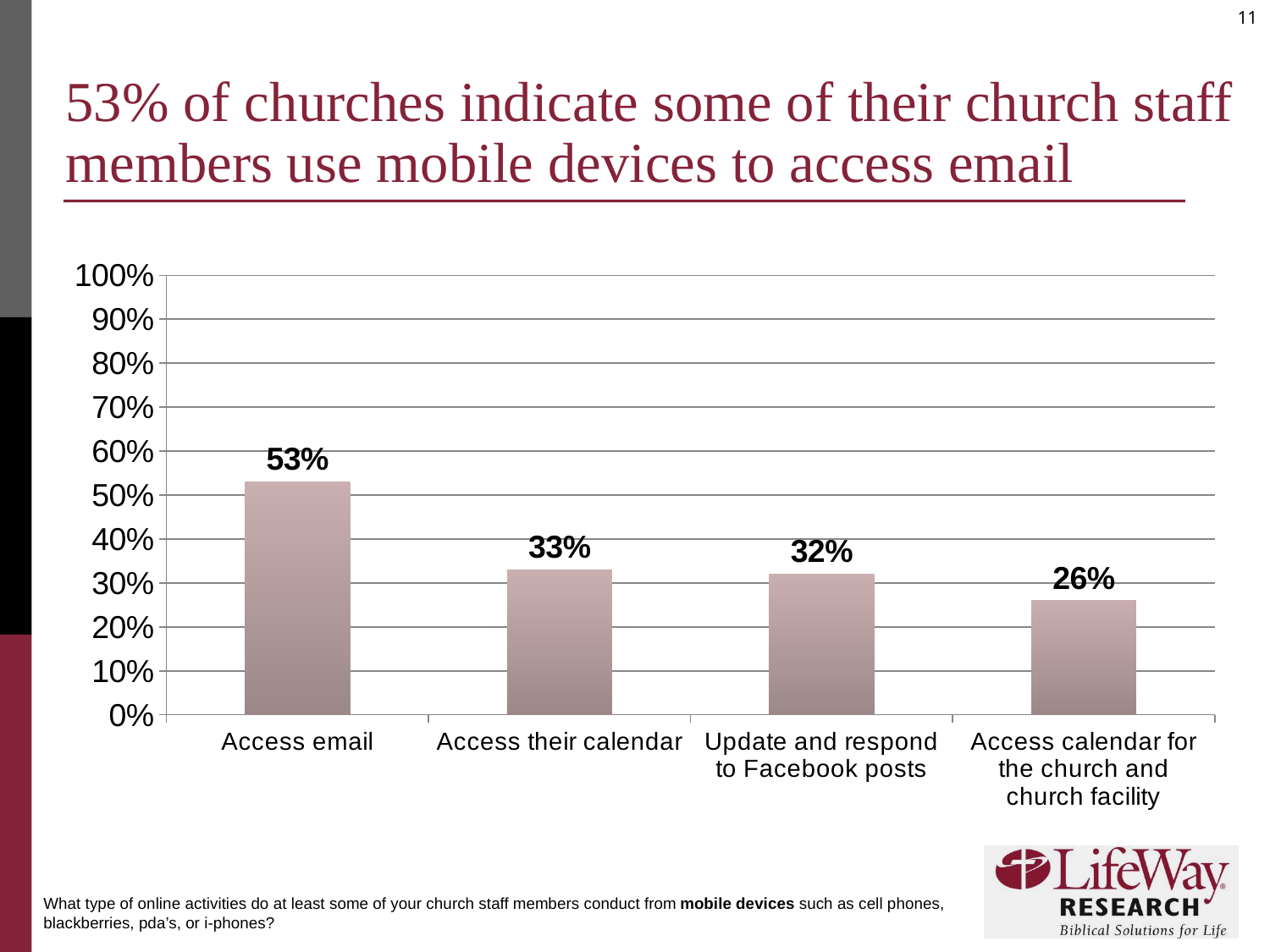
What is the difference between the values for 'Access email' and 'Access their calendar'? 20 percentage points Which activity has the lowest percentage? Access calendar for the church and church facility How many activity categories are shown in the chart? 4 What percentage of churches indicate staff members use mobile devices to access email? 53% What is the value for 'Access calendar for the church and church facility'? 26% Which is larger, the value for 'Access email' or the value for 'Access calendar for the church and church facility'? Access email What is the difference between the values for 'Update and respond to Facebook posts' and 'Access calendar for the church and church facility'? 6 percentage points What is the value for 'Access their calendar'? 33% Do the values rise or fall from left to right across the categories? Fall What is the value for 'Update and respond to Facebook posts'? 32% What type of chart is shown on the slide? Bar chart Which activity has the highest percentage? Access email